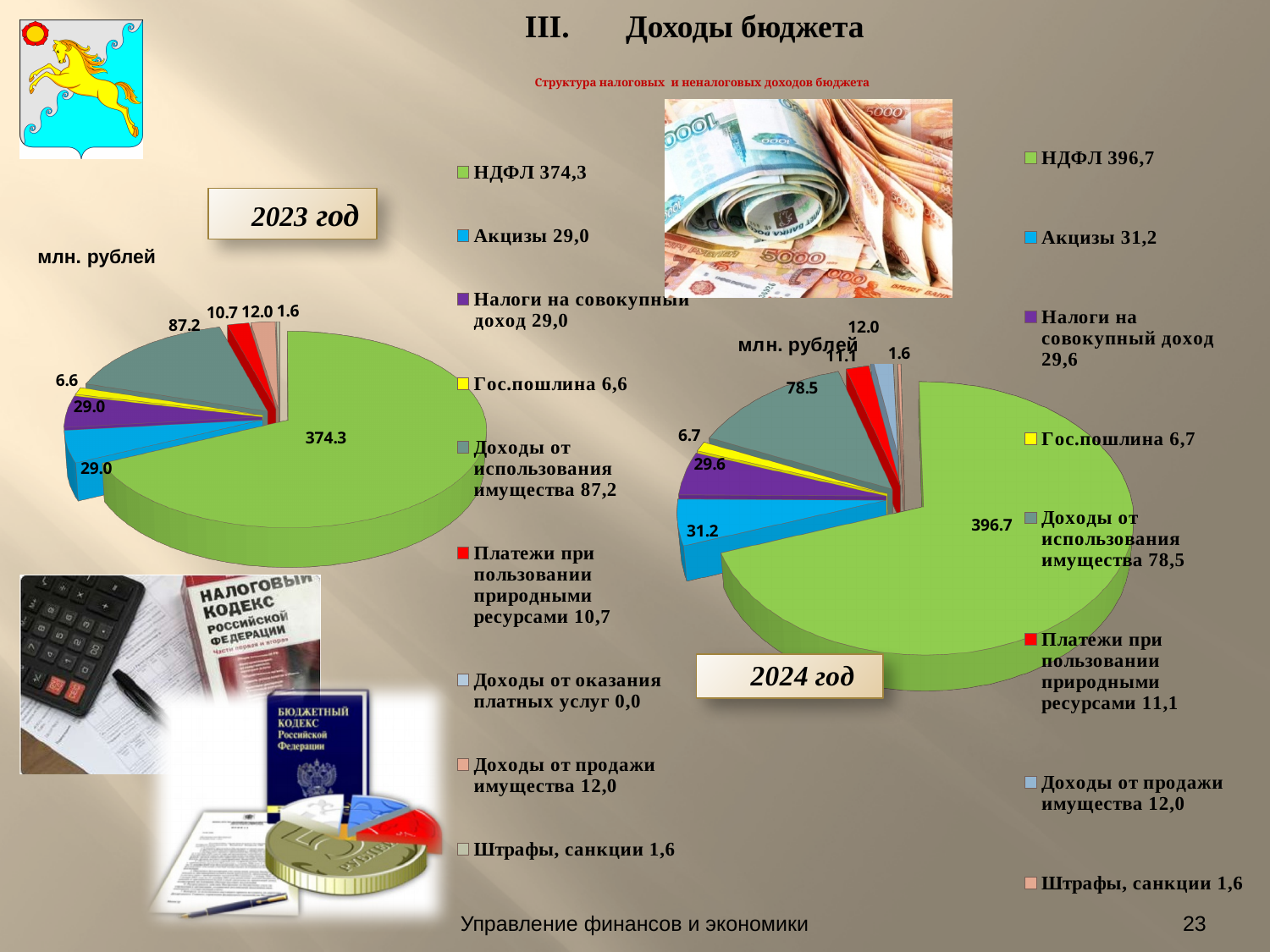
Which is larger: Доходы от использования имущества in the 2023 год chart or in the 2024 год chart? 2023 год How many entries does the legend of the 2023 год chart list? 9 On the 2024 год chart, what is the value for Акцизы? 31.2 On the 2023 год chart, which category has the largest slice? НДФЛ What is the difference between НДФЛ in the 2024 год chart and НДФЛ in the 2023 год chart? 22.4 What unit is stated for the values on both pie charts? млн. рублей What kind of chart is the 2023 год chart? pie chart On the 2024 год chart, which category has the smallest value? Штрафы, санкции On the 2024 год chart, what is the value for Доходы от использования имущества? 78.5 How many entries does the legend of the 2024 год chart list? 8 On the 2023 год chart, what is the value for НДФЛ? 374.3 On the 2023 год chart, what is the difference between Доходы от использования имущества and Акцизы? 58.2